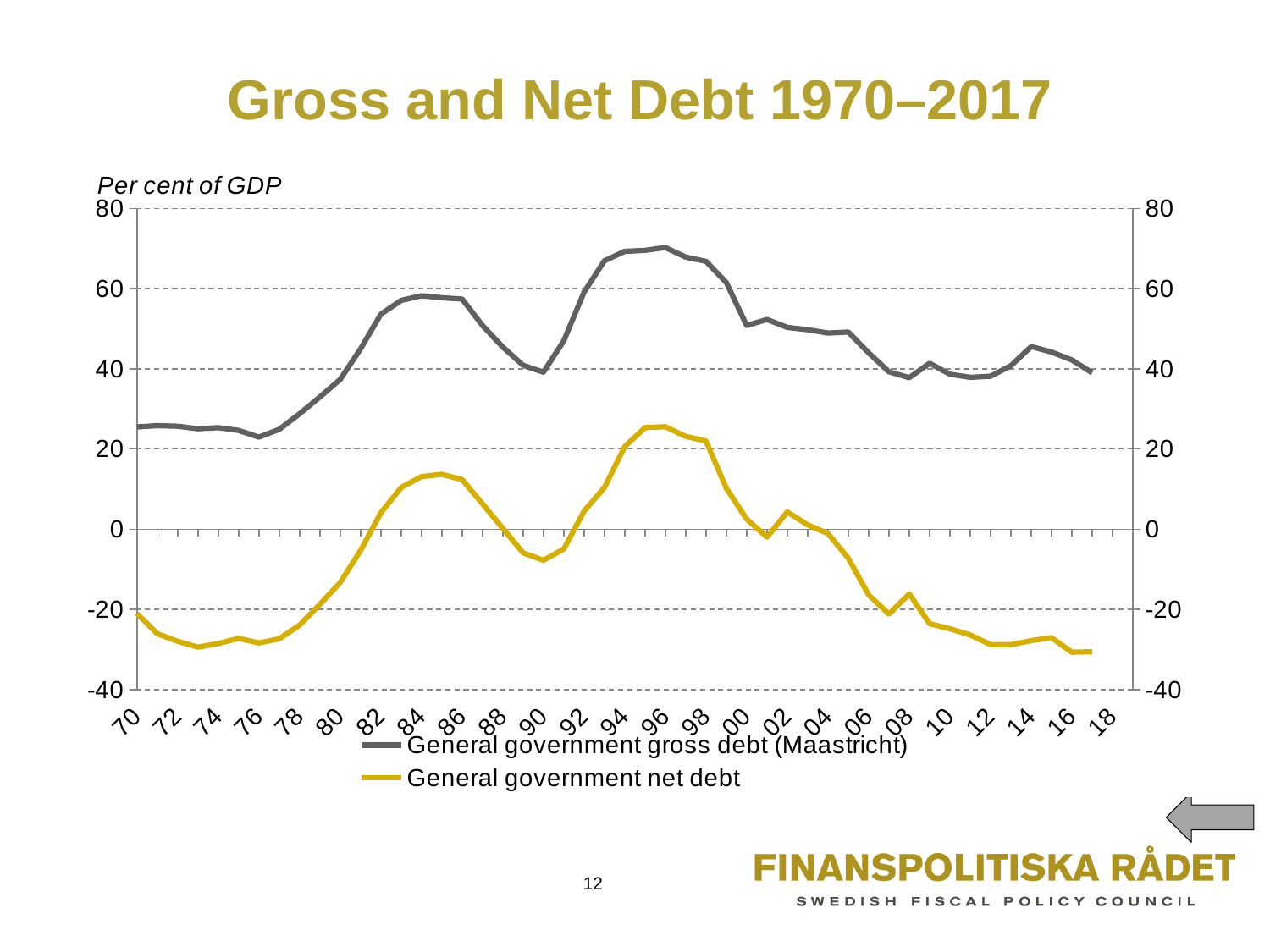
Is the value for General government gross debt (Maastricht) in 1970 greater or less than 40? less Is the value for General government gross debt (Maastricht) in 1996 greater or less than 60? greater What unit is the y axis measured in, according to the label above the chart? Per cent of GDP Does General government gross debt (Maastricht) rise or fall between 1990 and 1996? rise Does General government net debt rise or fall between 2008 and 2017? fall What is the title of the chart? Gross and Net Debt 1970–2017 What kind of chart is shown on the slide? line chart How many series does the legend list? 2 Is the value for General government gross debt (Maastricht) in 1984 greater or less than 40? greater Which series has the larger value in 1996, General government gross debt (Maastricht) or General government net debt? General government gross debt (Maastricht)